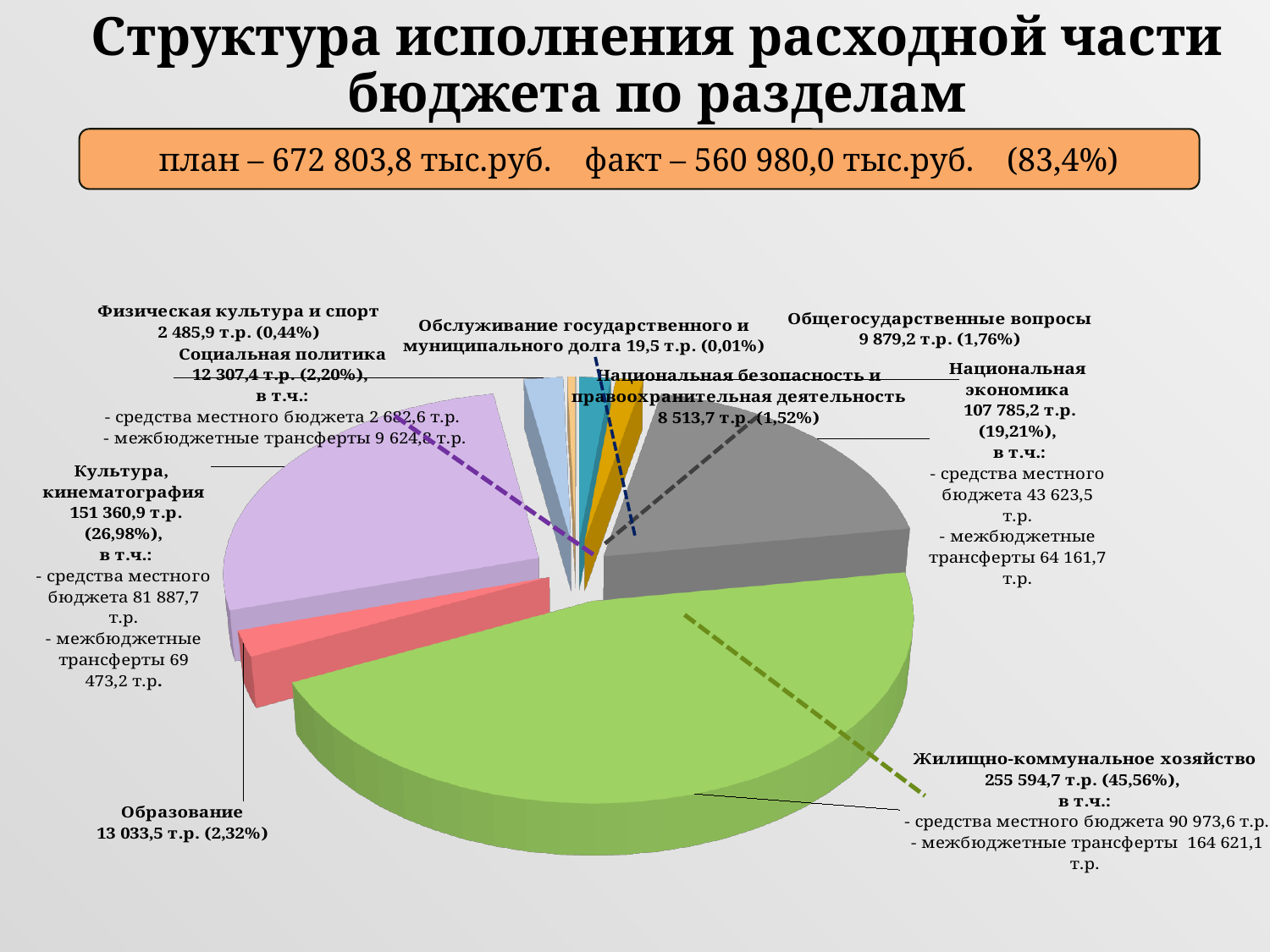
What share of the pie does Жилищно-коммунальное хозяйство represent? 45,56% What kind of chart is shown on the slide? Pie chart What is the value shown for Культура, кинематография? 151 360,9 т.р. What is the difference between the values for Культура, кинематография and Национальная экономика? 43 575,7 т.р. How many sections (slices) does the pie chart show? 9 Which is larger: Социальная политика or Образование? Образование Which section has the smallest share of the pie? Обслуживание государственного и муниципального долга What share of the pie does Образование represent? 2,32% What is the value shown for Обслуживание государственного и муниципального долга? 19,5 т.р. What is the title of the chart on the slide? Структура исполнения расходной части бюджета по разделам What is the value shown for Национальная экономика? 107 785,2 т.р. Which section has the largest share of the pie? Жилищно-коммунальное хозяйство